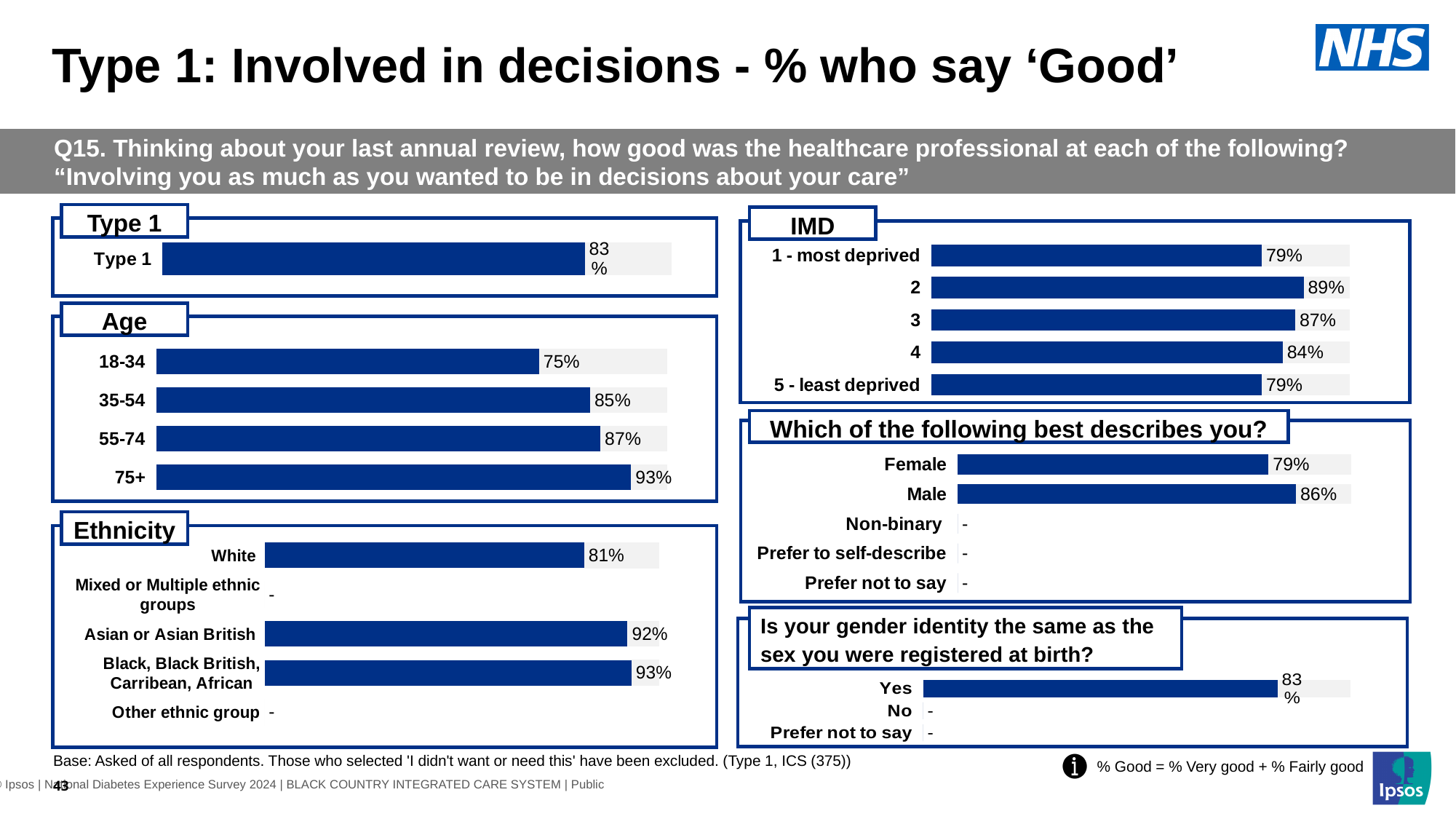
In the Ethnicity chart, which is larger: the value for White or the value for Black, Black British, Carribean, African? Black, Black British, Carribean, African In the IMD chart, how many categories are shown? 5 In the Ethnicity chart, what is the value for 'Asian or Asian British'? 92% In the 'Which of the following best describes you?' chart, what is the difference between the Male and Female values? 7 percentage points In the 'Is your gender identity the same as the sex you were registered at birth?' chart, what is the value for 'Yes'? 83% In the IMD chart, what is the value for '4'? 84% In the Age chart, which age group has the lowest percentage saying 'Good'? 18-34 In the Age chart, do the values rise or fall as age increases from 18-34 to 75+? Rise In the Age chart, what is the difference between the 55-74 and 18-34 values? 12 percentage points What type of chart is used in the Age section? Bar chart In the IMD chart, which group has the highest percentage saying 'Good'? 2 In the Age chart, what percentage of respondents aged 75+ say 'Good'? 93%